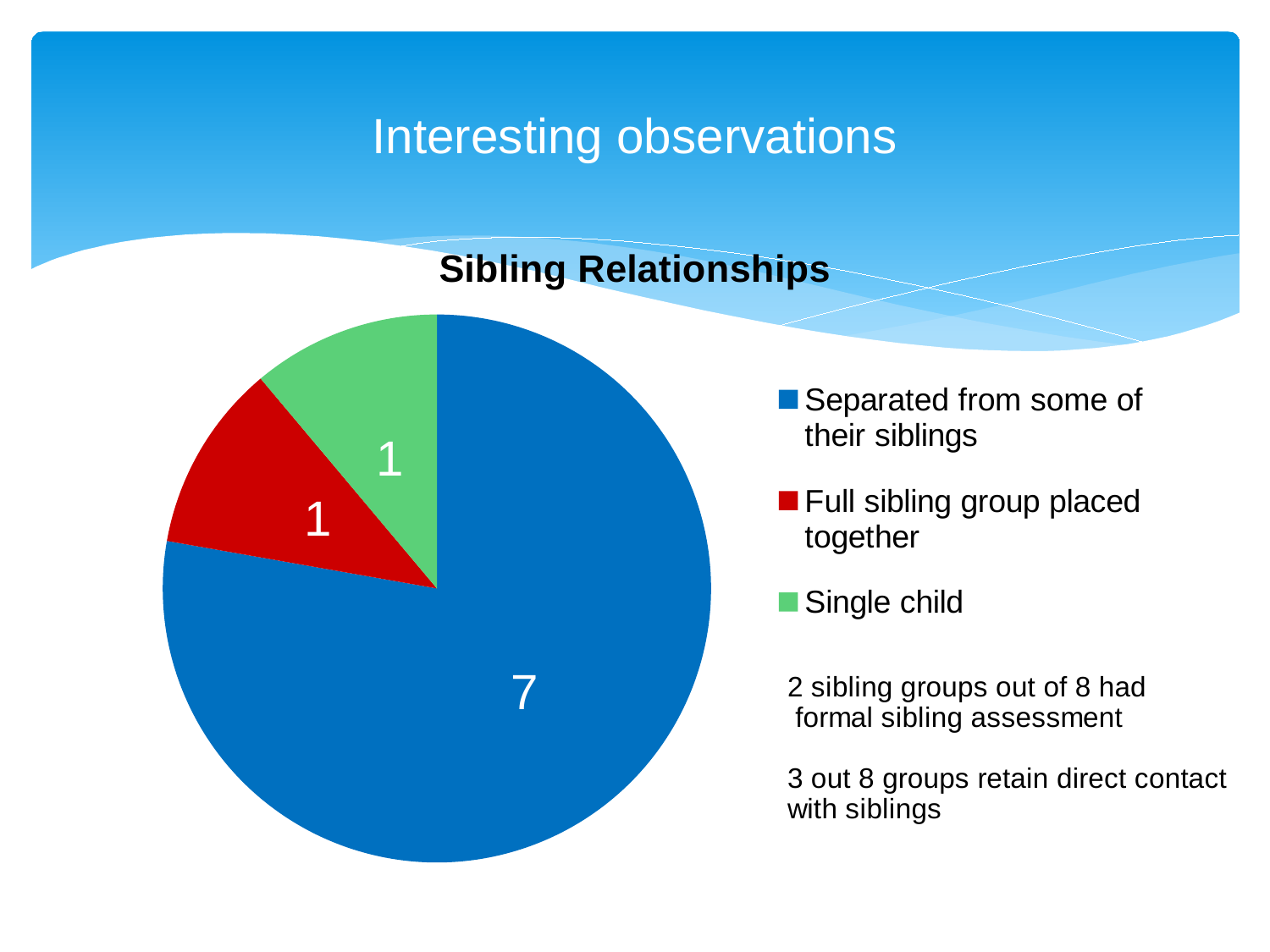
How many entries does the legend list? 3 How many categories does the pie chart show? 3 What is the value for "Separated from some of their siblings"? 7 What is the total of all slices in the pie chart? 9 What is the value for "Full sibling group placed together"? 1 Which is larger: the value for "Separated from some of their siblings" or the value for "Full sibling group placed together"? Separated from some of their siblings What is the value for "Single child"? 1 Which category has the largest slice of the pie? Separated from some of their siblings What is the difference between the value for "Separated from some of their siblings" and the value for "Single child"? 6 What type of chart is shown on the slide? pie chart What colour is the slice for "Single child"? green What is the title of the chart? Sibling Relationships